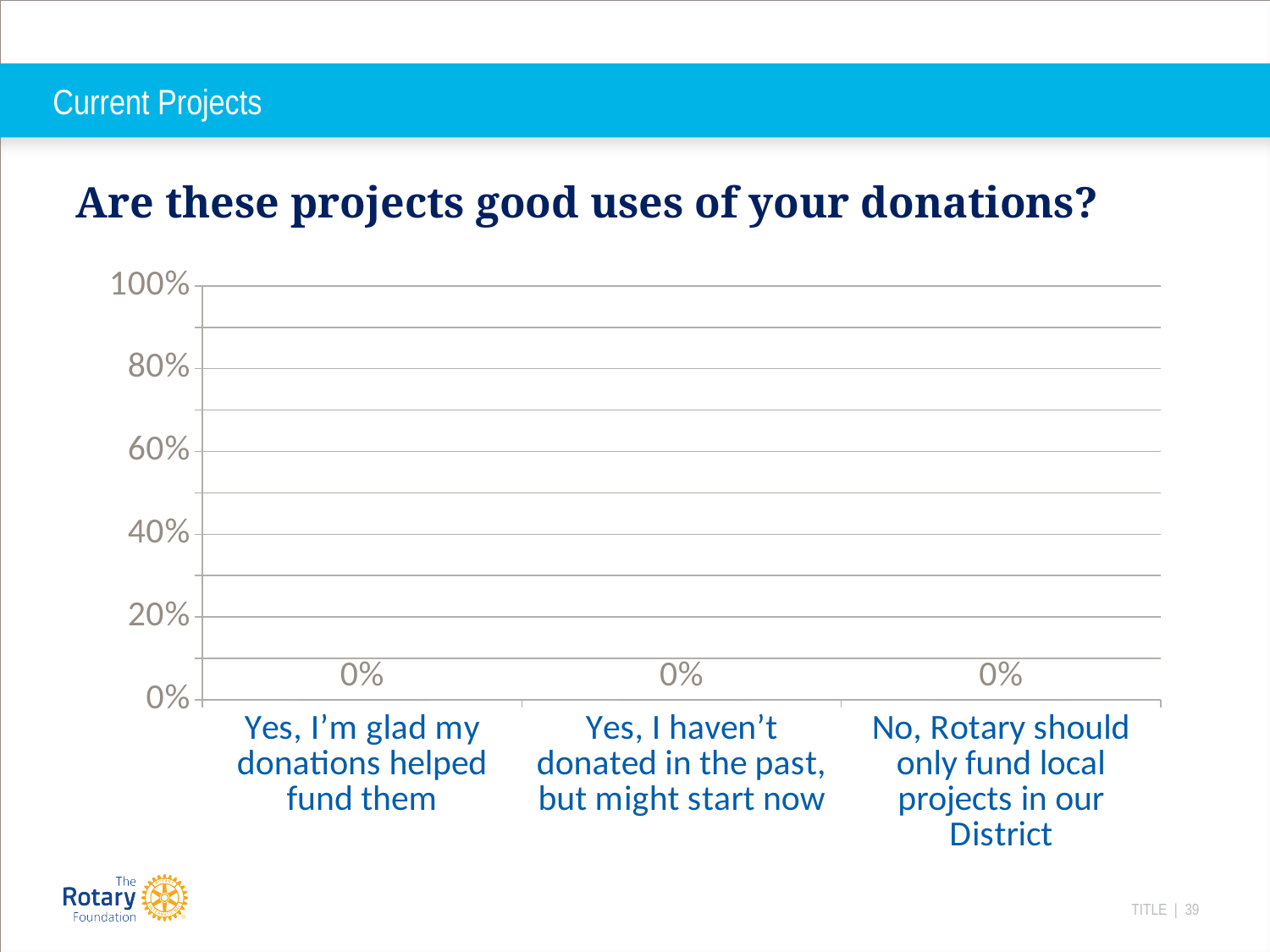
What is the highest value labelled on the y axis of the chart? 100% What is the title of the chart? Are these projects good uses of your donations? What is the value for "No, Rotary should only fund local projects in our District"? 0% What is the value for "Yes, I haven't donated in the past, but might start now"? 0% Is the value for "Yes, I haven't donated in the past, but might start now" greater or less than 20%? less What is the difference between the value for "Yes, I'm glad my donations helped fund them" and the value for "No, Rotary should only fund local projects in our District"? 0% How many categories are shown on the x axis of the chart? 3 What is the value for "Yes, I'm glad my donations helped fund them"? 0% Is the value for "No, Rotary should only fund local projects in our District" greater or less than 40%? less